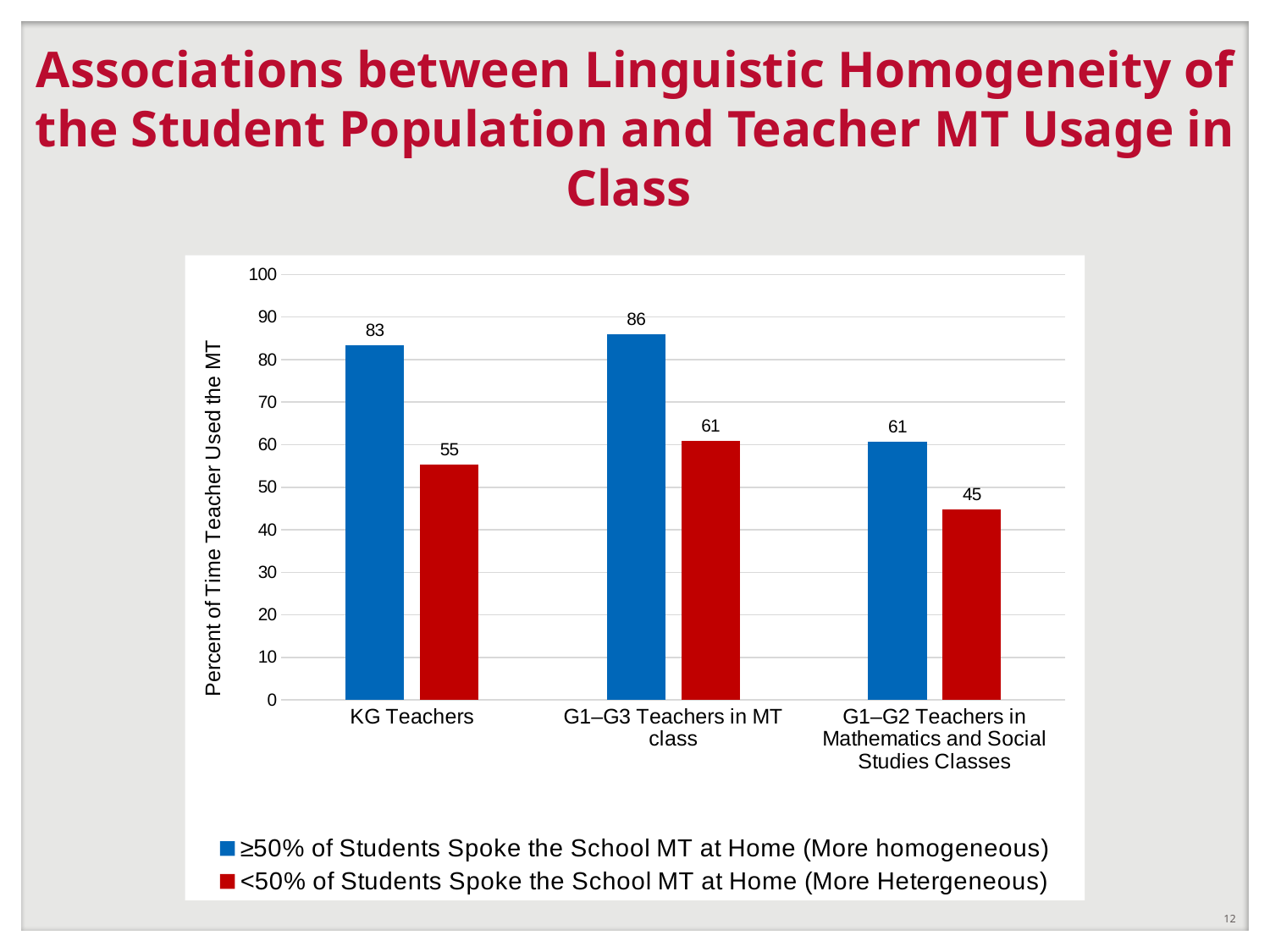
How many series does the legend list? 2 What kind of chart is shown on the slide? Bar chart Which is larger: the ≥50% (More homogeneous) value for G1–G2 Teachers in Mathematics and Social Studies Classes or the <50% (More Hetergeneous) value for KG Teachers? ≥50% (More homogeneous) value for G1–G2 Teachers in Mathematics and Social Studies Classes Which category has the highest value in the ≥50% of Students Spoke the School MT at Home (More homogeneous) series? G1–G3 Teachers in MT class What is the difference between the two series for KG Teachers? 28 Which category has the lowest value in the <50% of Students Spoke the School MT at Home (More Hetergeneous) series? G1–G2 Teachers in Mathematics and Social Studies Classes What is the value for G1–G2 Teachers in Mathematics and Social Studies Classes in the <50% of Students Spoke the School MT at Home (More Hetergeneous) series? 45 What is the difference between the two series for G1–G3 Teachers in MT class? 25 How many categories are shown on the x axis? 3 What is the label of the vertical axis? Percent of Time Teacher Used the MT What is the value for KG Teachers in the ≥50% of Students Spoke the School MT at Home (More homogeneous) series? 83 What is the value for G1–G3 Teachers in MT class in the <50% of Students Spoke the School MT at Home (More Hetergeneous) series? 61